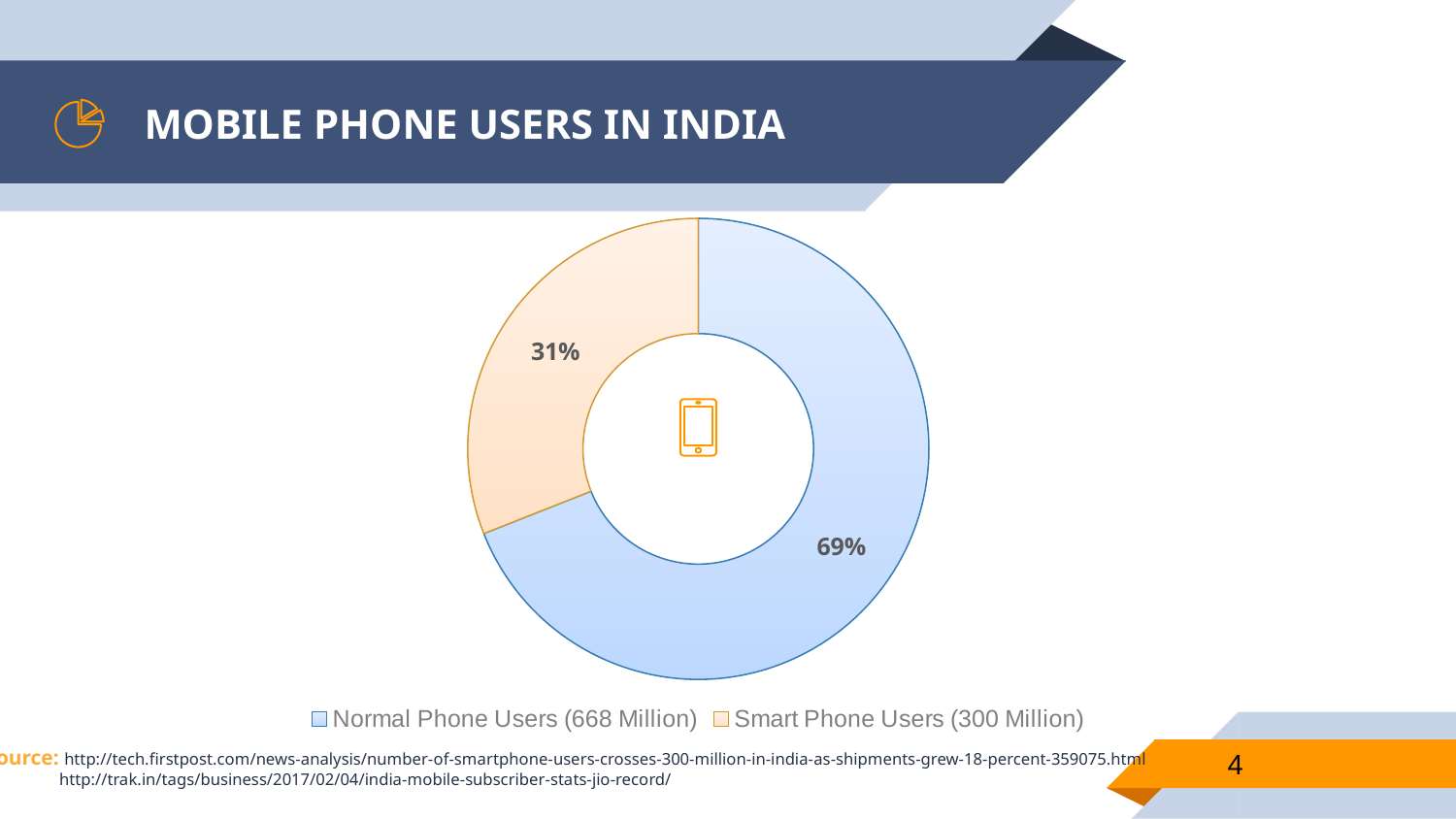
What is the title of the slide containing the chart? MOBILE PHONE USERS IN INDIA What is the difference in percentage points between the Normal Phone Users slice and the Smart Phone Users slice? 38 What kind of chart is shown on the slide? Pie chart (doughnut) Which slice is larger, Normal Phone Users or Smart Phone Users? Normal Phone Users What share of the pie is labelled for Normal Phone Users? 69% How many entries does the legend list? 2 What share of the pie is labelled for Smart Phone Users? 31% According to the legend, how many million Smart Phone Users are there? 300 Million How many slices does the pie chart have? 2 Which category has the largest slice of the pie? Normal Phone Users (668 Million) Which category has the smallest slice of the pie? Smart Phone Users (300 Million) What colour is the Smart Phone Users slice in the chart? Orange